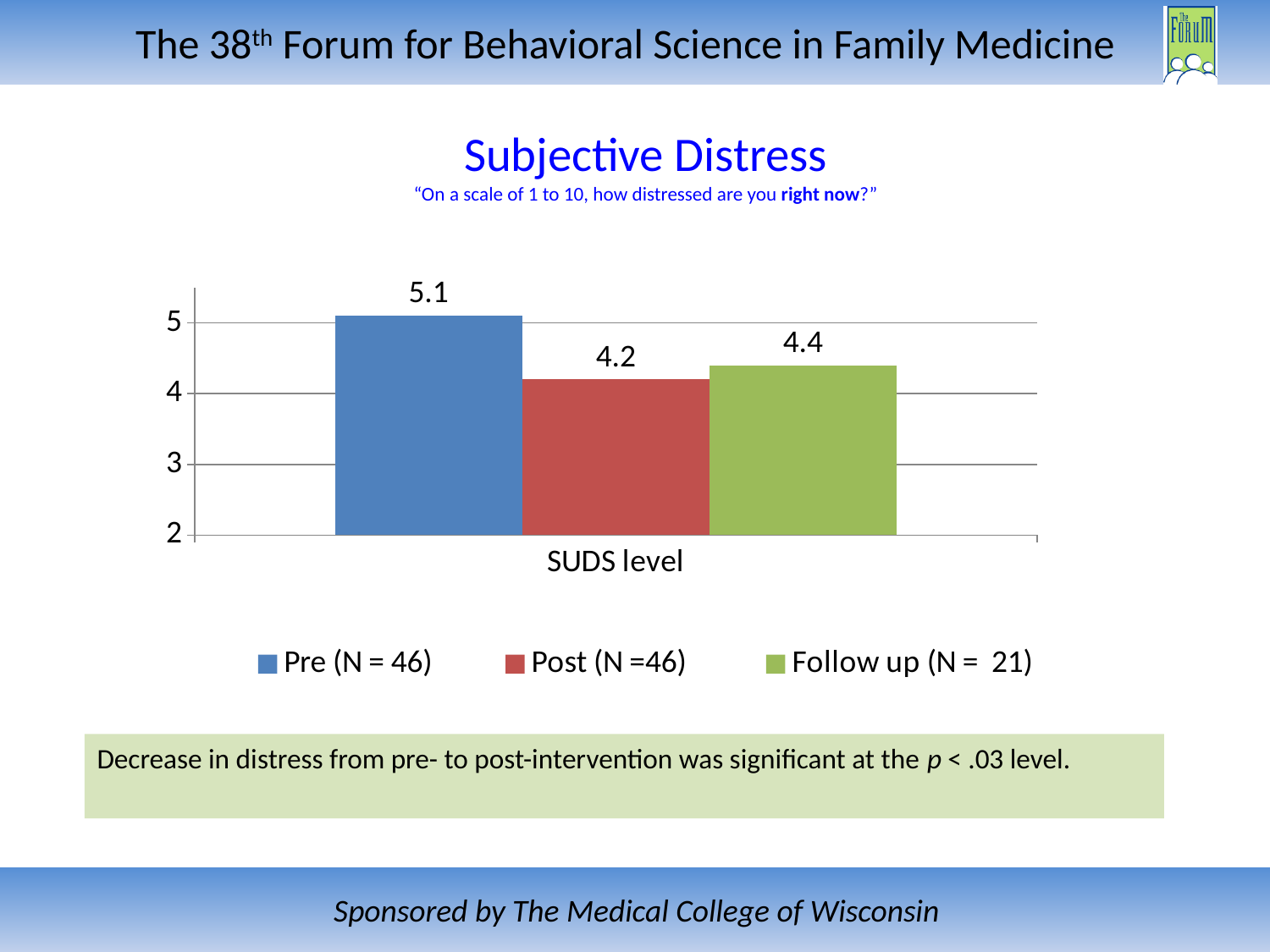
What is the SUDS level value for Follow up (N = 21)? 4.4 Which series has the highest SUDS level? Pre (N = 46) What is the SUDS level value for Post (N =46)? 4.2 Which series has the lowest SUDS level? Post (N =46) What is the difference between the Pre and Post SUDS levels? 0.9 What is the title of the chart? Subjective Distress Is the value for Pre (N = 46) greater or less than 5? greater What kind of chart is shown on the slide? Bar chart What is the difference between the Follow up and Post SUDS levels? 0.2 Which is larger, the Pre SUDS level or the Follow up SUDS level? Pre (N = 46) How many series does the legend list? 3 What is the SUDS level value for Pre (N = 46)? 5.1